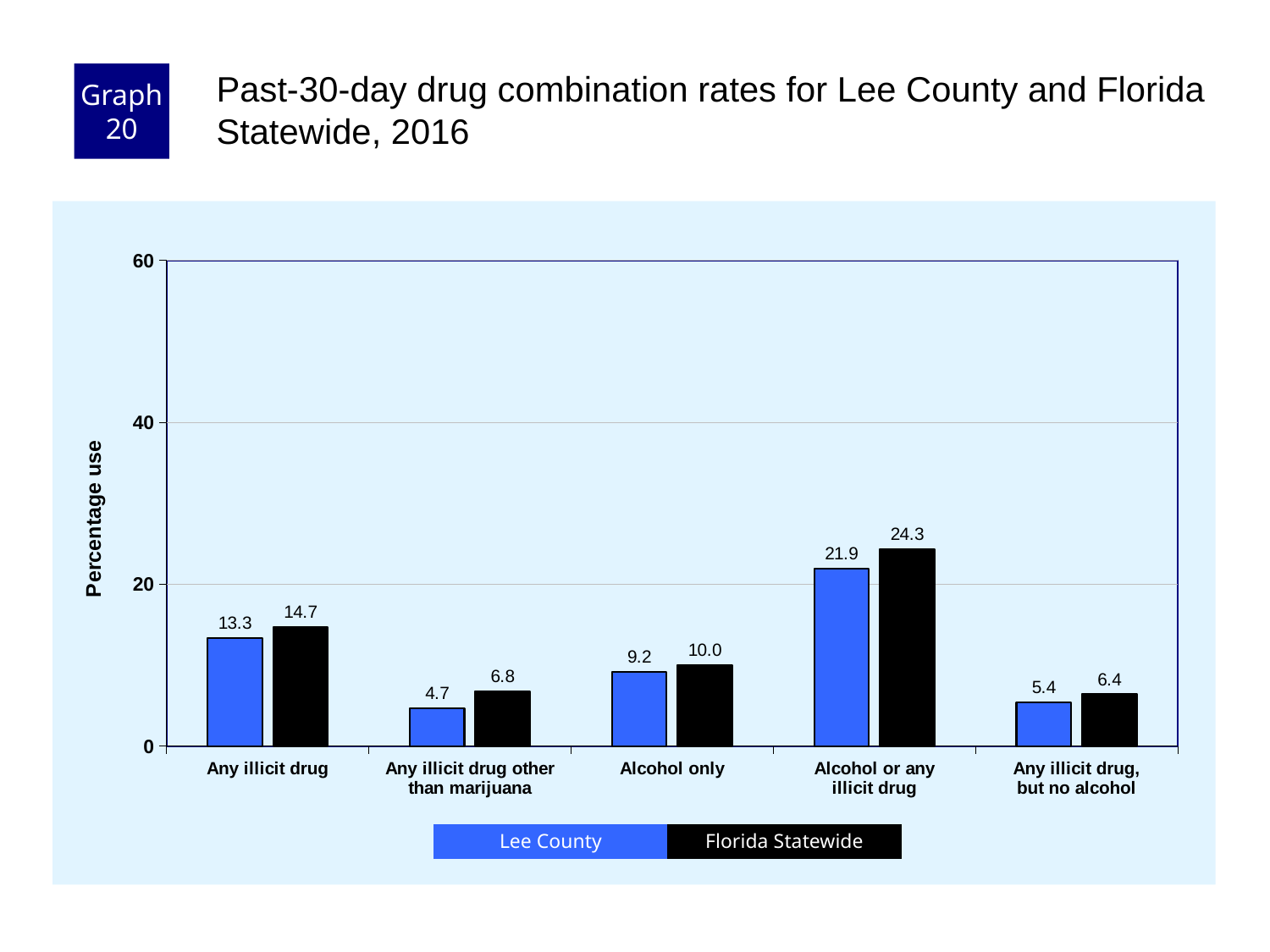
What is the Lee County value for Any illicit drug? 13.3 Which is larger for Alcohol only: Lee County or Florida Statewide? Florida Statewide Is the Florida Statewide value for Any illicit drug greater or less than 20? less How many series does the legend list? 2 Which category has the lowest Florida Statewide value? Any illicit drug, but no alcohol What is the Lee County value for Any illicit drug other than marijuana? 4.7 What is the difference between the Florida Statewide and Lee County values for Alcohol or any illicit drug? 2.4 Which category has the highest Lee County value? Alcohol or any illicit drug What is the label of the y axis? Percentage use What is the Florida Statewide value for Alcohol or any illicit drug? 24.3 How many categories are shown on the x axis? 5 What kind of chart is shown? bar chart